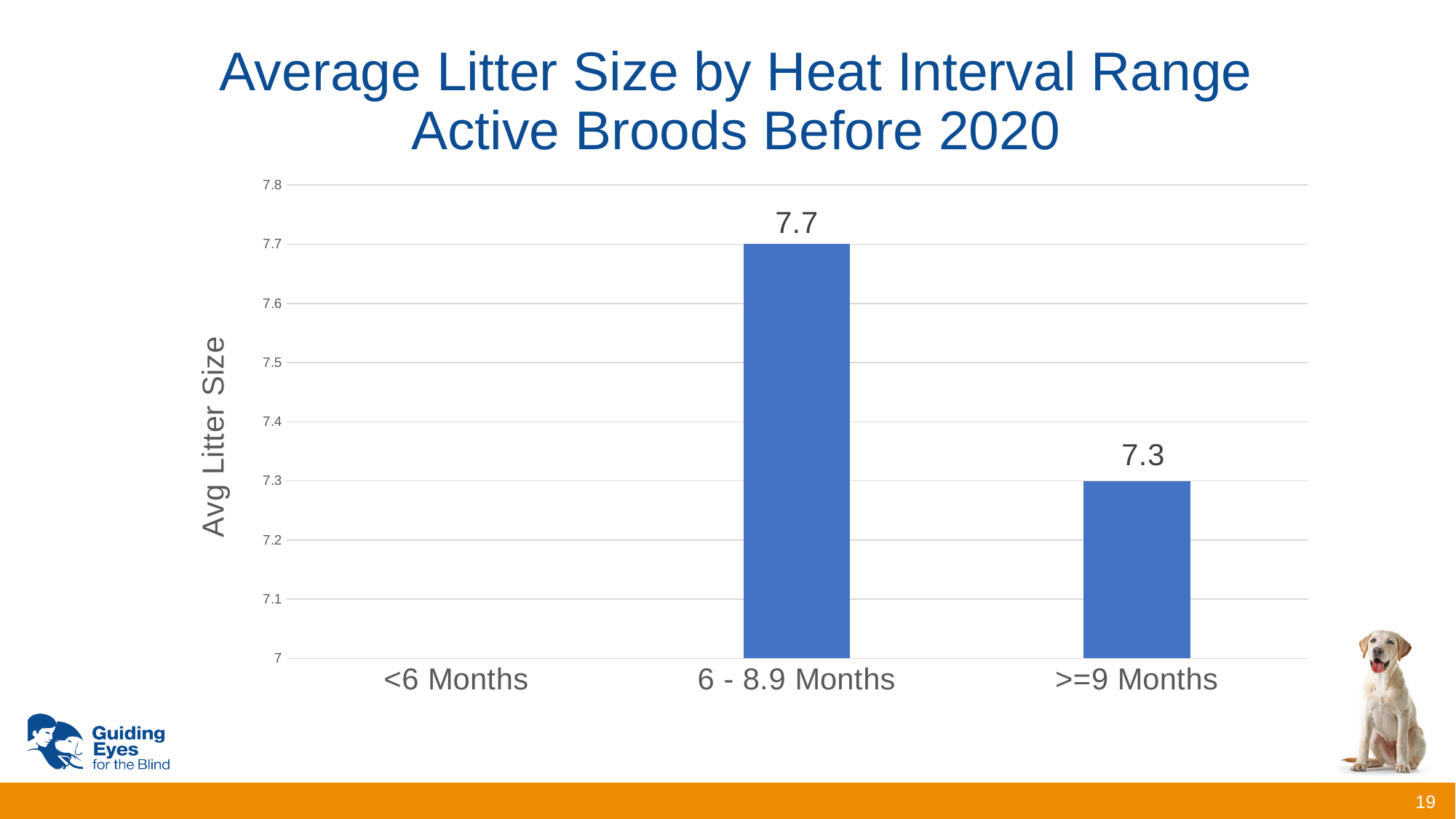
What is the difference in average litter size between the 6 - 8.9 Months and >=9 Months ranges? 0.4 Does the average litter size rise or fall from the 6 - 8.9 Months range to the >=9 Months range? Fall Which heat interval range has the highest average litter size? 6 - 8.9 Months Is the value for >=9 Months greater or less than 7.5? less What kind of chart is shown on the slide? Bar chart How many heat interval range categories are labelled on the x axis? 3 What is the average litter size for the 6 - 8.9 Months heat interval range? 7.7 What is the title of the chart? Average Litter Size by Heat Interval Range Active Broods Before 2020 What is the label of the vertical axis? Avg Litter Size Is the value for 6 - 8.9 Months greater or less than 7.5? greater Which has a larger average litter size, 6 - 8.9 Months or >=9 Months? 6 - 8.9 Months What is the average litter size for the >=9 Months heat interval range? 7.3